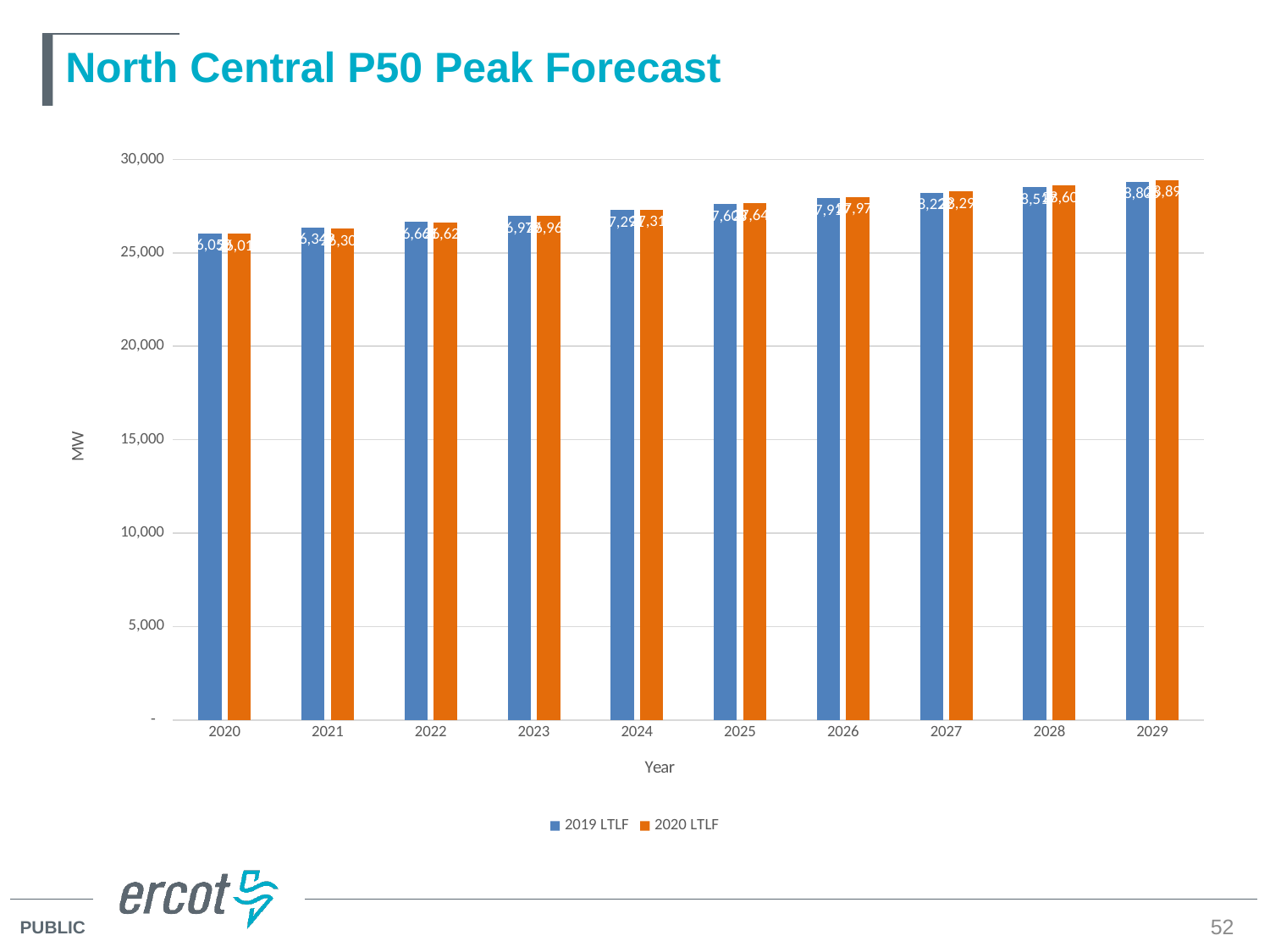
Is the 2019 LTLF value for 2024 greater or less than 25,000? greater Is the 2020 LTLF value for 2029 greater or less than 30,000? less How many years are shown on the x axis? 10 Is the 2019 LTLF value for 2020 greater or less than 25,000? greater Which year has the lowest value for the 2020 LTLF series? 2020 For the 2020 LTLF series, which is larger: the value for 2029 or the value for 2020? 2029 Do the 2020 LTLF values rise or fall from 2020 to 2029? rise What is the label on the y axis? MW How many series does the legend list? 2 Which year has the highest value for the 2019 LTLF series? 2029 What kind of chart is shown on the slide? bar chart What is the title of the chart? North Central P50 Peak Forecast